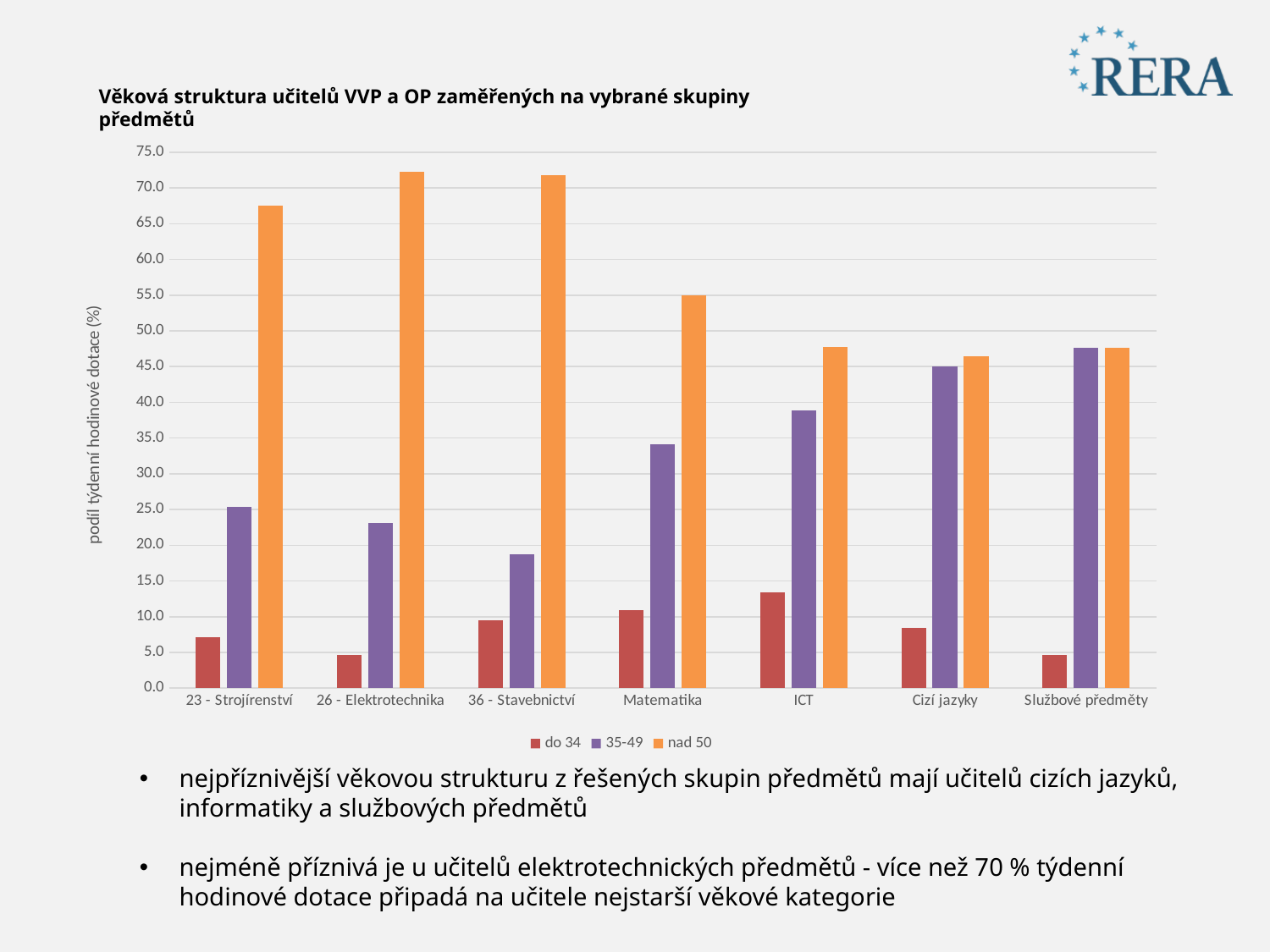
Which is larger: the 'do 34' value for 23 - Strojírenství or the 'do 34' value for 26 - Elektrotechnika? 23 - Strojírenství Is the 'nad 50' value for Matematika greater or less than 50.0? greater Which is larger: the '35-49' value for Matematika or the '35-49' value for ICT? ICT What is the label of the vertical axis? podíl týdenní hodinové dotace (%) Is the 'do 34' value for ICT greater or less than 10.0? greater How many series does the legend list? 3 How many subject groups (categories) are shown on the x axis? 7 Which subject group has the lowest value for the '35-49' series? 36 - Stavebnictví What kind of chart is shown on the slide? bar chart Which subject group has the highest value for the 'do 34' series? ICT Is the '35-49' value for 36 - Stavebnictví greater or less than 20.0? less